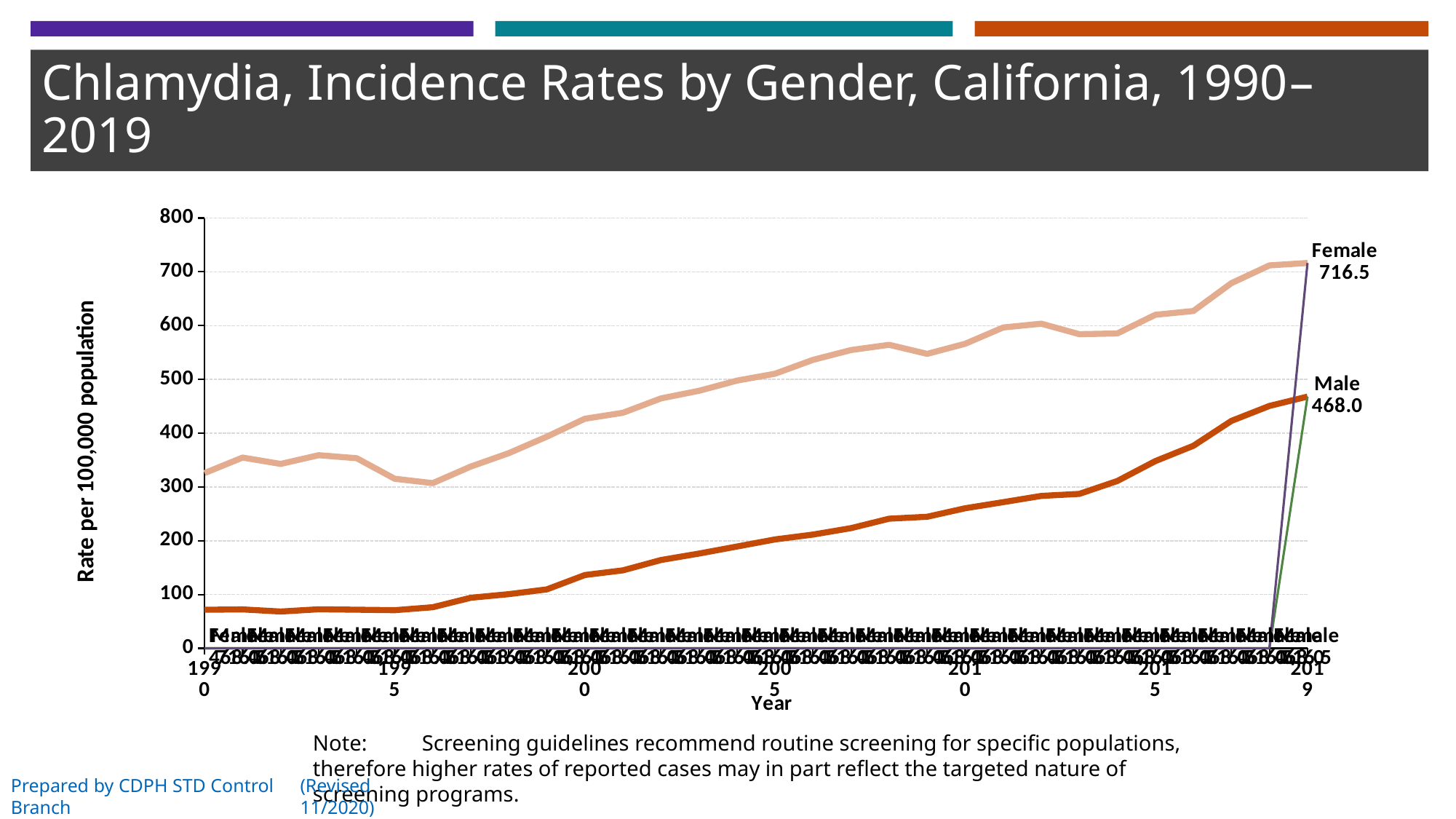
What is the Male chlamydia incidence rate in 2019? 468.0 Is the Male rate in 2010 greater or less than 200? greater What is the difference between the Female and Male rates in 2019? 248.5 What type of chart is shown on the slide? line chart What is the label of the vertical axis? Rate per 100,000 population What is the Female chlamydia incidence rate in 2019? 716.5 Is the Female rate in 2015 greater or less than 600? greater Does the Male rate generally rise or fall from 1990 to 2019? rise Is the Female rate in 1990 greater or less than 300? greater How many series are plotted on the chart? 2 Which series has the higher rate in 2019, Female or Male? Female